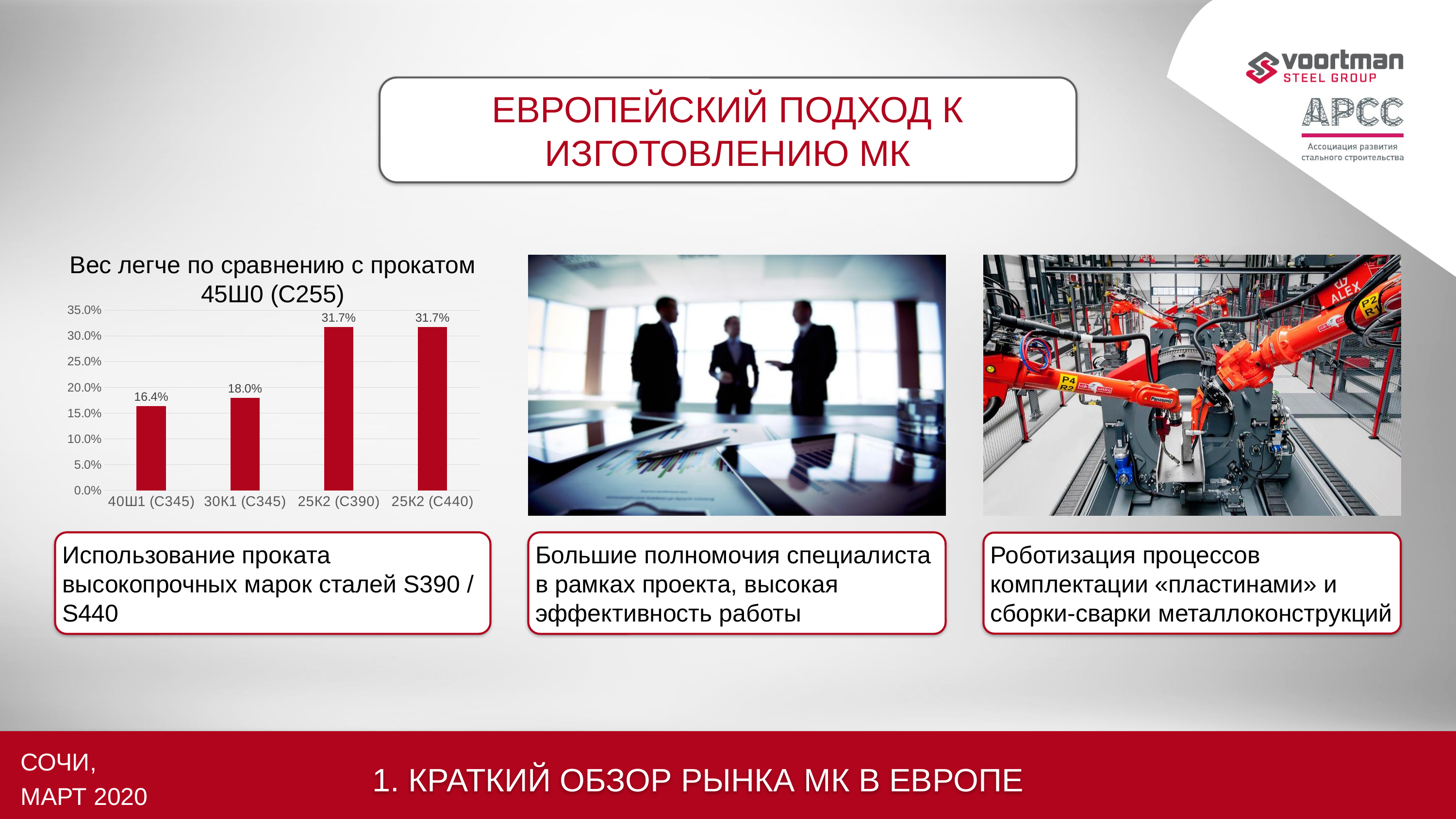
What kind of chart is shown on the slide? bar chart How many categories are shown in the chart? 4 What is the value for 25К2 (С390) in the chart? 31.7% Which category has the lowest value in the chart? 40Ш1 (С345) What is the difference between the values for 30К1 (С345) and 40Ш1 (С345)? 1.6% What is the title of the chart? Вес легче по сравнению с прокатом 45Ш0 (С255) Is the value for 40Ш1 (С345) greater or less than 20.0%? less Which is larger, the value for 30К1 (С345) or the value for 40Ш1 (С345)? 30К1 (С345) What is the value for 30К1 (С345) in the chart? 18.0% What is the difference between the values for 25К2 (С390) and 30К1 (С345)? 13.7% What is the value for 40Ш1 (С345) in the chart? 16.4% What is the value for 25К2 (С440) in the chart? 31.7%